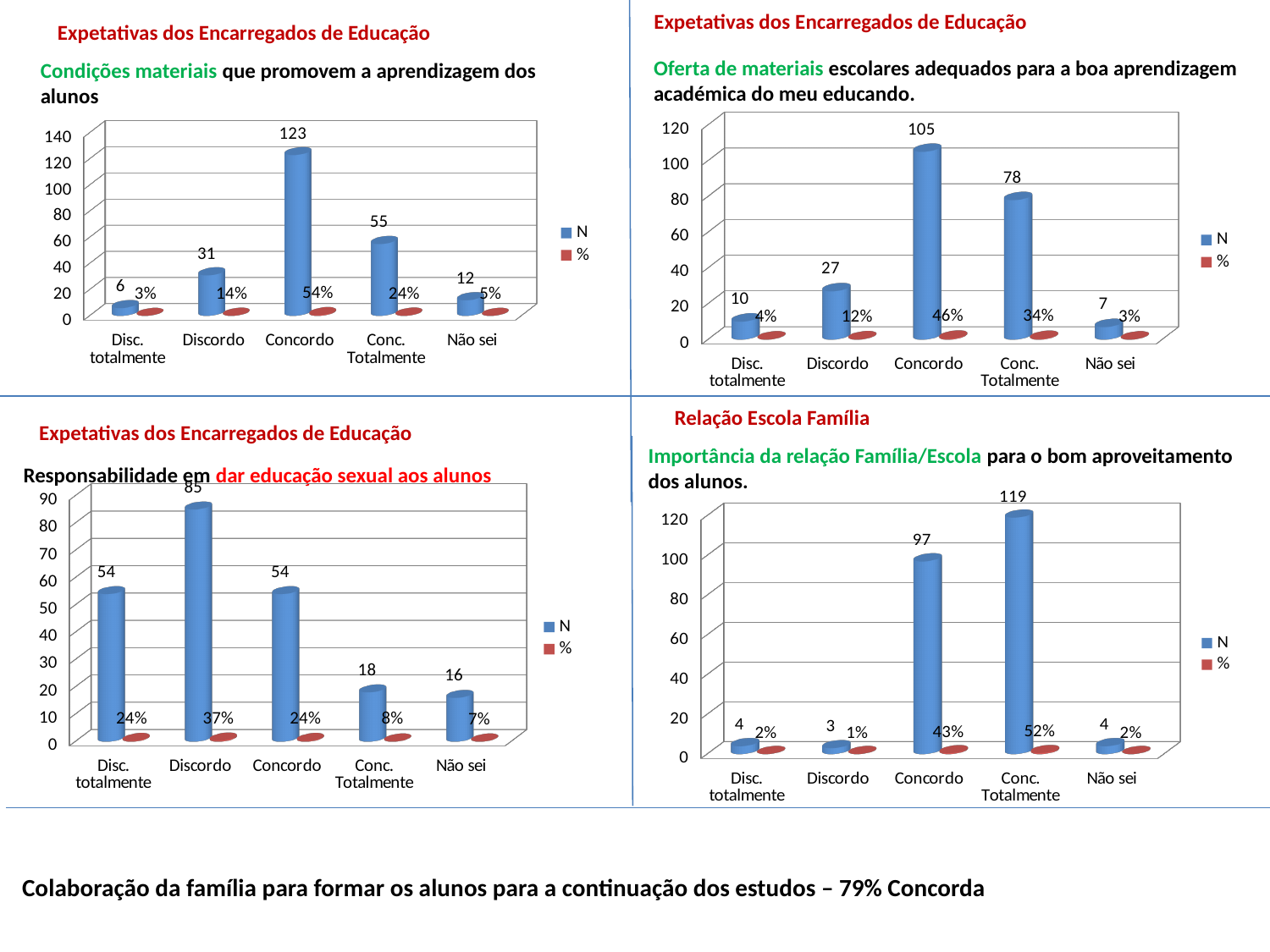
How many categories are shown on the x axis of the bottom-right chart (Importância da relação Família/Escola)? 5 In the bottom-left chart (Responsabilidade em dar educação sexual aos alunos), what is the N value for Discordo? 85 In the top-left chart (Condições materiais), which category has the lowest N value? Disc. totalmente How many series does the legend of the top-left chart (Condições materiais) list? 2 In the top-left chart (Condições materiais), what is the N value for Concordo? 123 In the top-right chart (Oferta de materiais), is the N value for Discordo greater or less than 40? less In the top-right chart (Oferta de materiais), which category has the highest N value? Concordo In the top-left chart (Condições materiais), what is the difference between the N values for Concordo and Conc. Totalmente? 68 In the bottom-right chart (Importância da relação Família/Escola), what percentage is shown for Concordo? 43% In the bottom-right chart (Importância da relação Família/Escola), what is the N value for Conc. Totalmente? 119 In the top-right chart (Oferta de materiais), what percentage is shown for Conc. Totalmente? 34% In the bottom-left chart (Responsabilidade em dar educação sexual aos alunos), which is larger, the N value for Conc. Totalmente or for Não sei? Conc. Totalmente